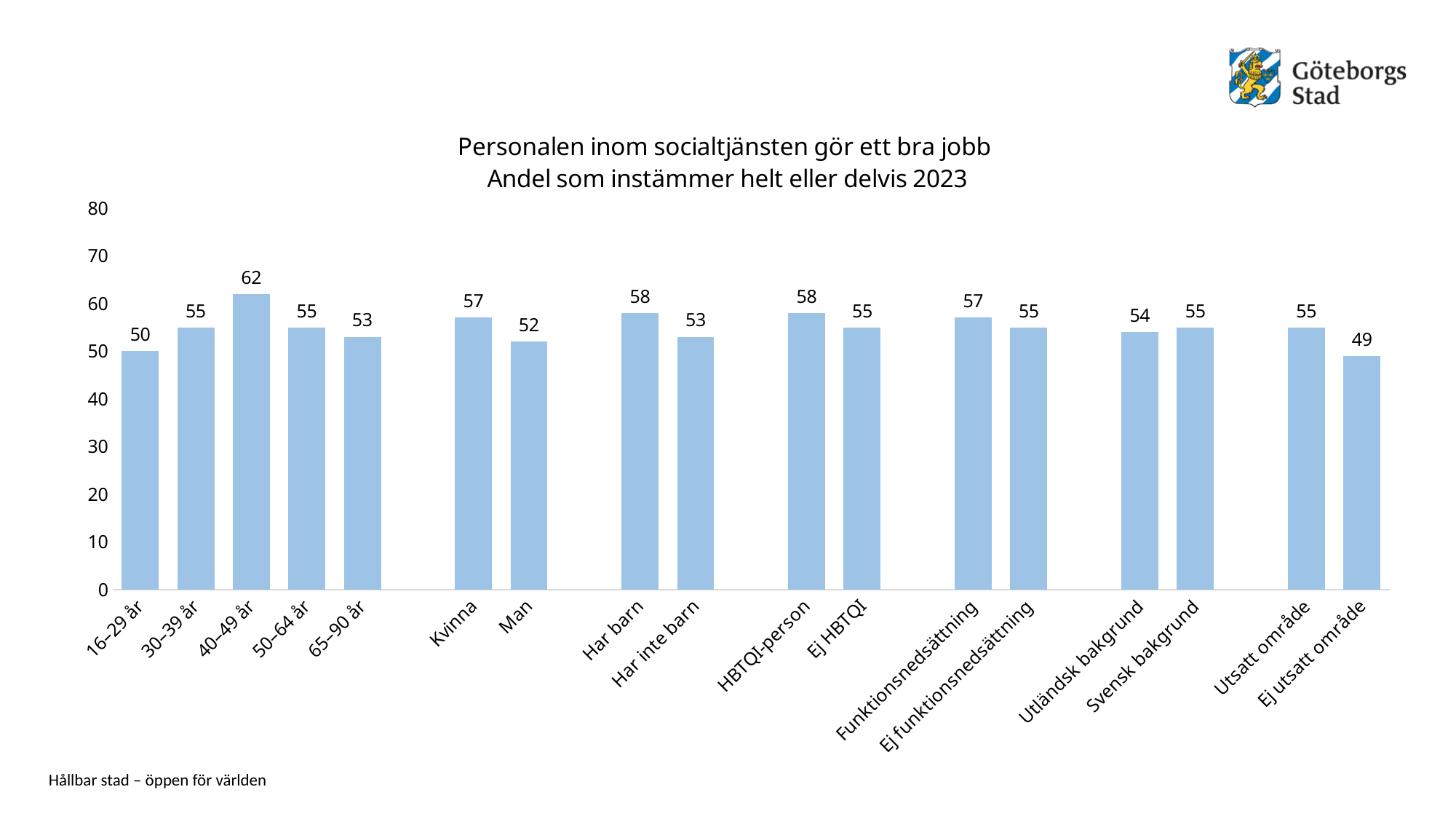
How many categories are shown on the x axis? 17 What is the value for 40–49 år? 62 Which category has the highest value? 40–49 år What kind of chart is this? bar chart Which category has the lowest value? Ej utsatt område What is the difference between the values for Utländsk bakgrund and Svensk bakgrund? 1 What is the value for Kvinna? 57 Which is larger, the value for HBTQI-person or the value for Ej HBTQI? HBTQI-person What is the second line of the chart title? Andel som instämmer helt eller delvis 2023 Is the value for 16–29 år greater or less than 60? less What is the difference between the values for Har barn and Har inte barn? 5 What is the value for Ej utsatt område? 49